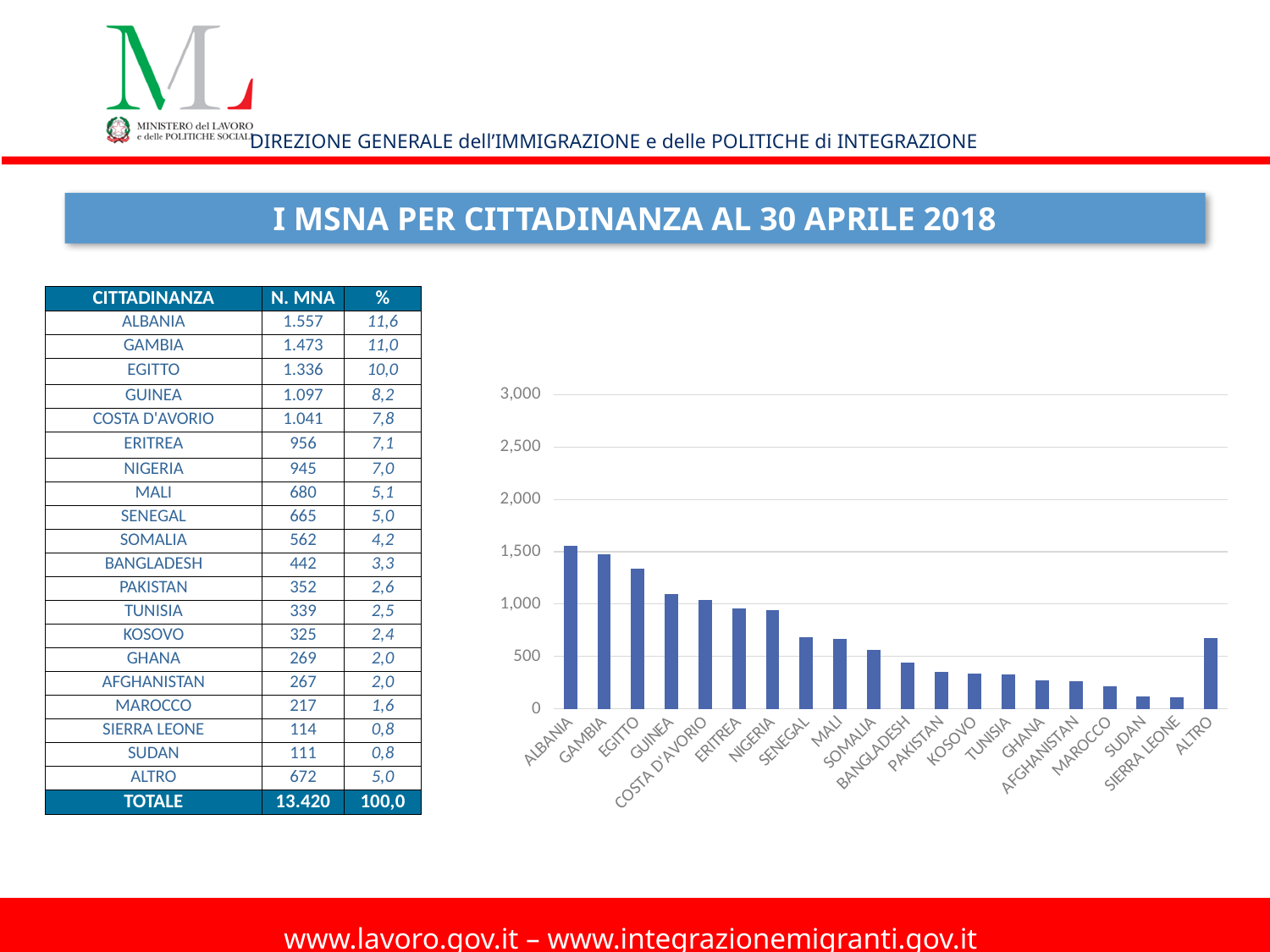
Is the value for GHANA greater or less than 500? less According to the table on the slide, what is the N. MNA value for ALBANIA? 1.557 Excluding the final ALTRO bar, do the values rise or fall from left to right along the x axis? fall What is the highest tick value shown on the chart's vertical axis? 3,000 Which category has the highest bar in the chart? ALBANIA Which is larger, the value for GAMBIA or the value for EGITTO? GAMBIA Is the value for EGITTO greater or less than 1,000? greater Which is larger, the value for ALTRO or the value for SUDAN? ALTRO What kind of chart is shown on the slide? bar chart How many categories (bars) does the chart show? 20 Is the value for PAKISTAN greater or less than 500? less